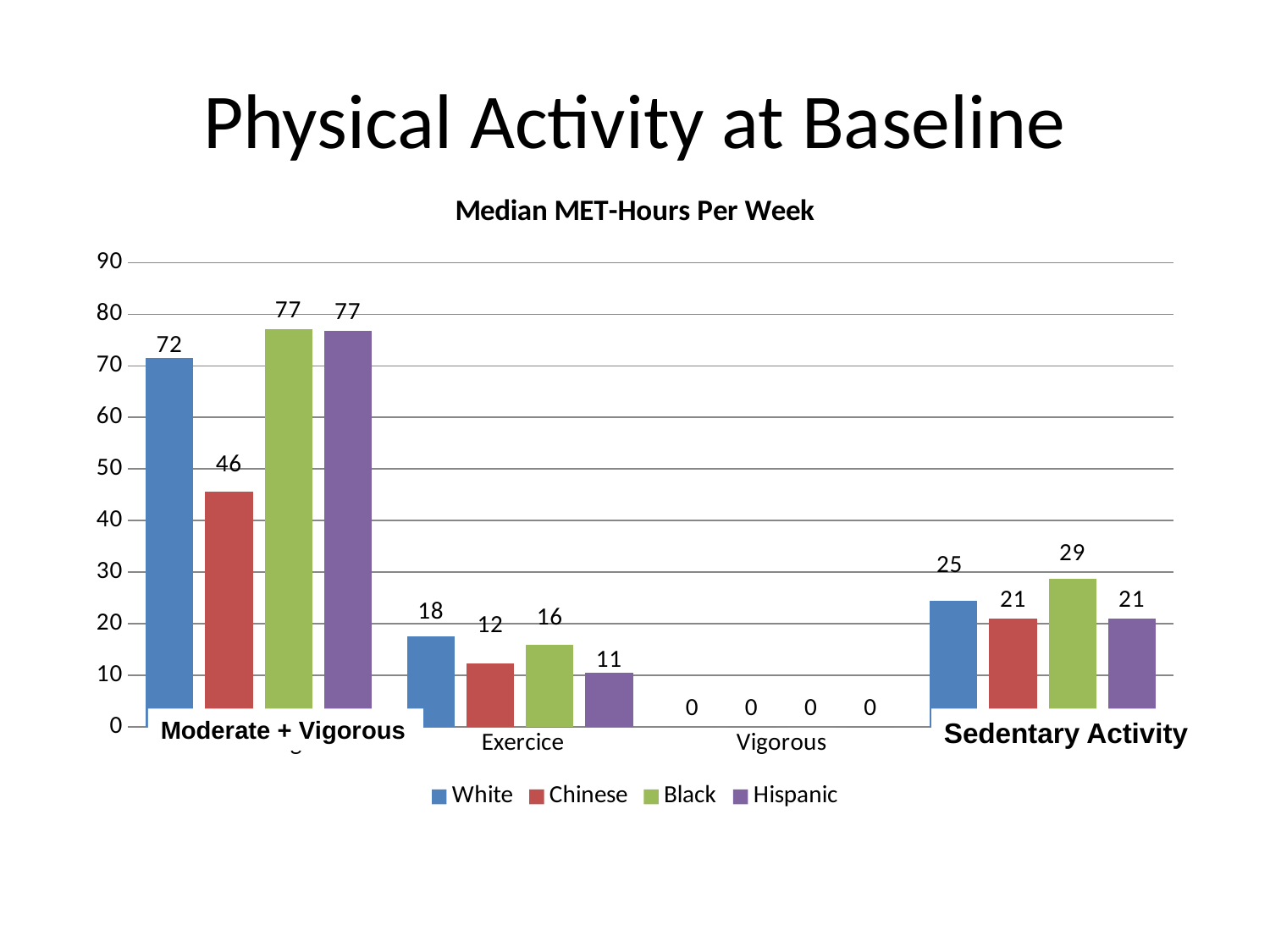
What is the difference between the Black and Chinese values in the Moderate + Vigorous category? 31 What is the value for Chinese in the Moderate + Vigorous category? 46 How many categories are shown on the x axis? 4 Which series has the highest value in the Exercice category? White What is the value for Hispanic in the Exercice category? 11 What kind of chart is shown on the slide? Bar chart What is the title of the chart? Median MET-Hours Per Week Which series has the lowest value in the Moderate + Vigorous category? Chinese Which is larger in the Sedentary Activity category, the value for White or the value for Chinese? White What is the value for White in the Moderate + Vigorous category? 72 How many series does the legend list? 4 What is the value for Black in the Sedentary Activity category? 29